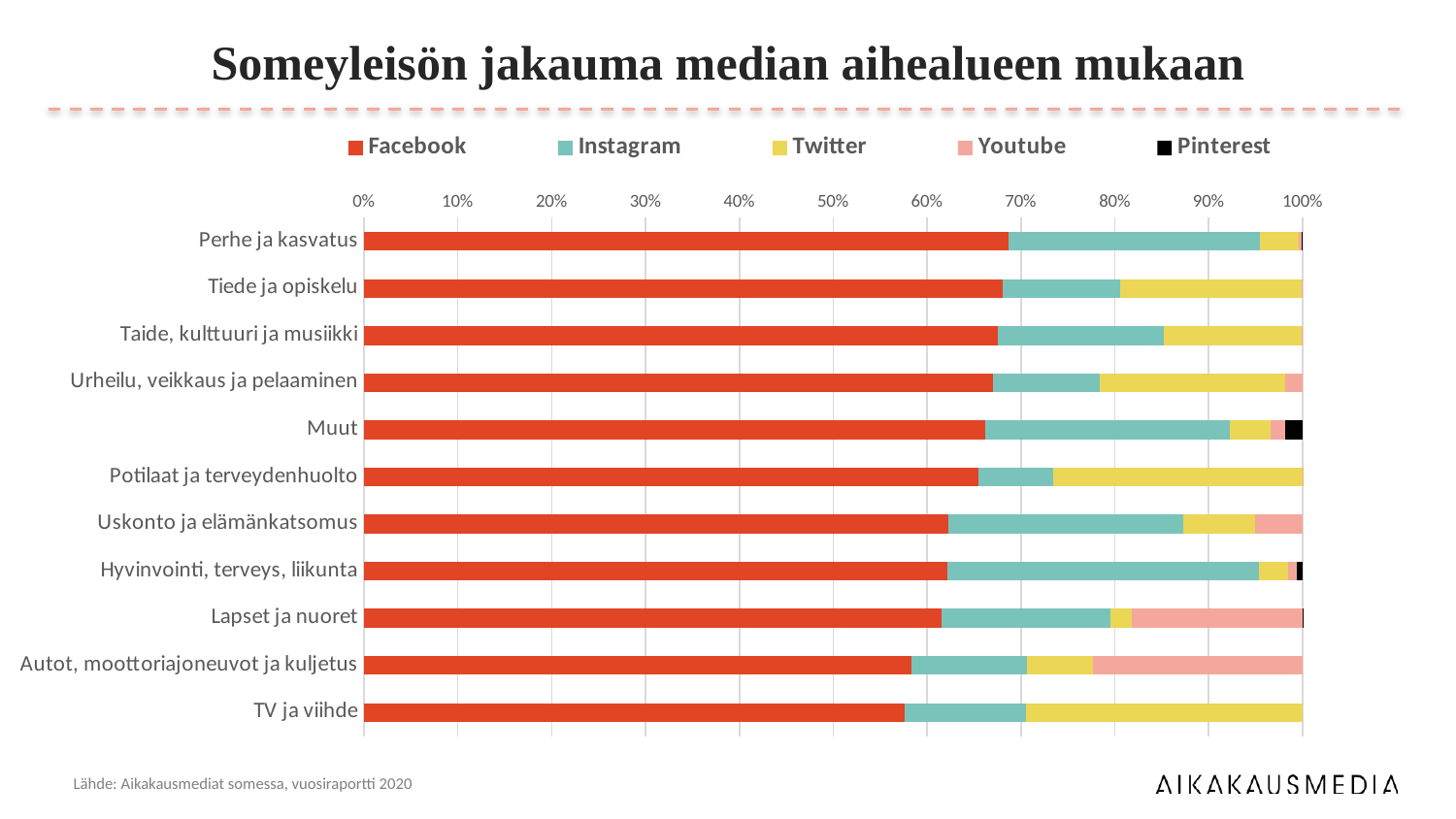
What kind of chart is shown on the slide? Stacked bar chart Which has a larger Twitter share, TV ja viihde or Perhe ja kasvatus? TV ja viihde What does each stacked bar in the chart total? 100% What is the title of the chart? Someyleisön jakauma median aihealueen mukaan Is the Facebook share for Perhe ja kasvatus greater or less than 60%? greater Which has a larger Facebook share, Perhe ja kasvatus or TV ja viihde? Perhe ja kasvatus Which has a larger Youtube share, Autot, moottoriajoneuvot ja kuljetus or Uskonto ja elämänkatsomus? Autot, moottoriajoneuvot ja kuljetus Is the Facebook share for Lapset ja nuoret greater or less than 70%? less How many series does the legend list? 5 Is the Facebook share for TV ja viihde greater or less than 50%? greater How many media topic categories are listed on the chart? 11 Which social media platform is shown in red in the chart? Facebook